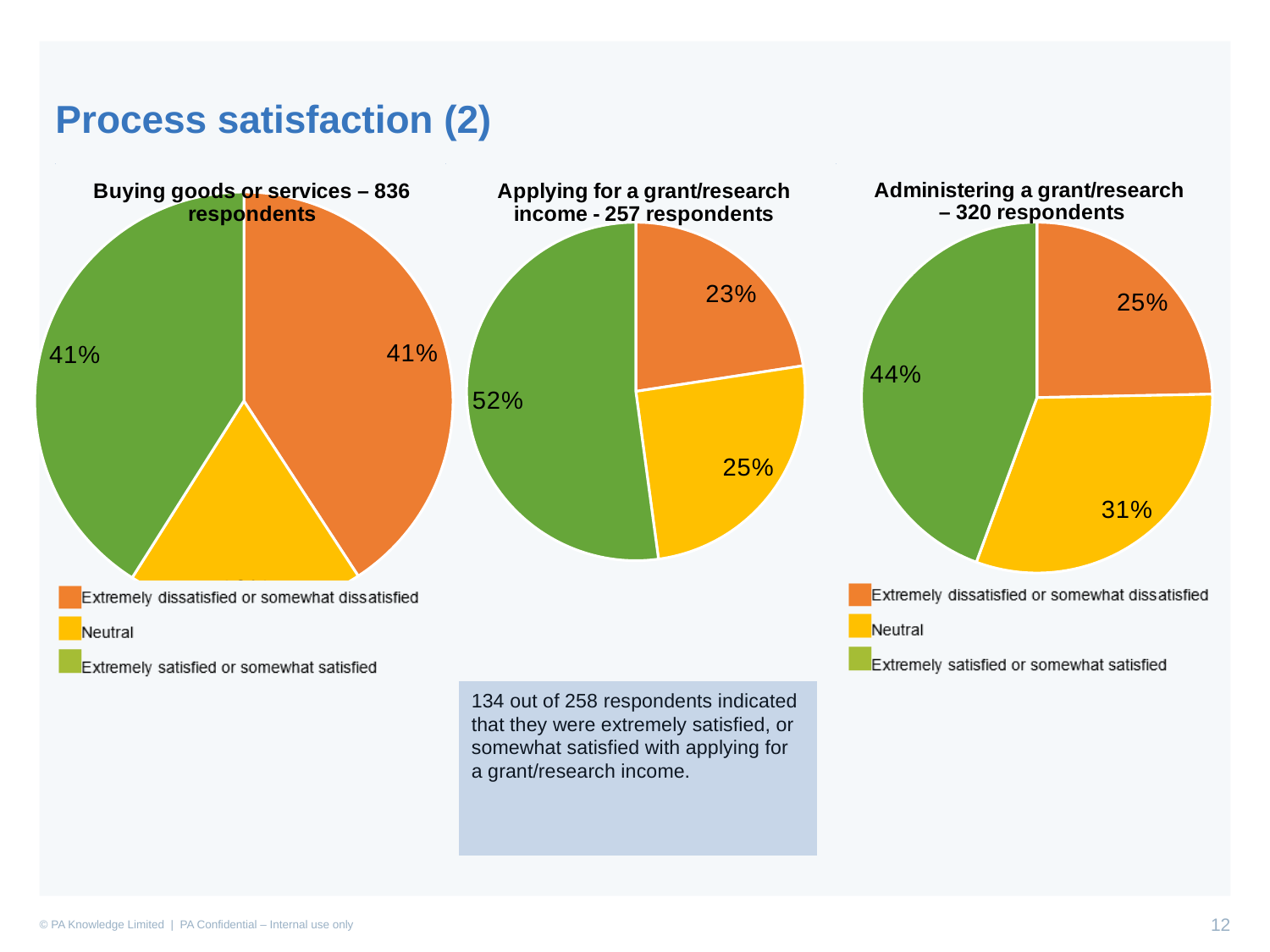
In the 'Applying for a grant/research income' chart, what share of respondents were extremely satisfied or somewhat satisfied? 52% In the 'Administering a grant/research' chart, what share of respondents were extremely dissatisfied or somewhat dissatisfied? 25% How many respondents does the 'Buying goods or services' chart title state? 836 In the 'Administering a grant/research' chart, what is the difference in percentage points between the neutral slice and the dissatisfied slice? 6 percentage points In the 'Buying goods or services' chart, what share of respondents were extremely dissatisfied or somewhat dissatisfied? 41% In the 'Administering a grant/research' chart, what share of respondents were neutral? 31% What type of chart is used on this slide? Pie chart In the 'Applying for a grant/research income' chart, which category has the largest slice? Extremely satisfied or somewhat satisfied Which chart has the larger neutral share: 'Applying for a grant/research income' or 'Administering a grant/research'? Administering a grant/research In the 'Administering a grant/research' chart, which category has the smallest slice? Extremely dissatisfied or somewhat dissatisfied In the 'Applying for a grant/research income' chart, what is the difference in percentage points between the satisfied slice and the dissatisfied slice? 29 percentage points How many slices does the 'Buying goods or services' pie chart have? 3